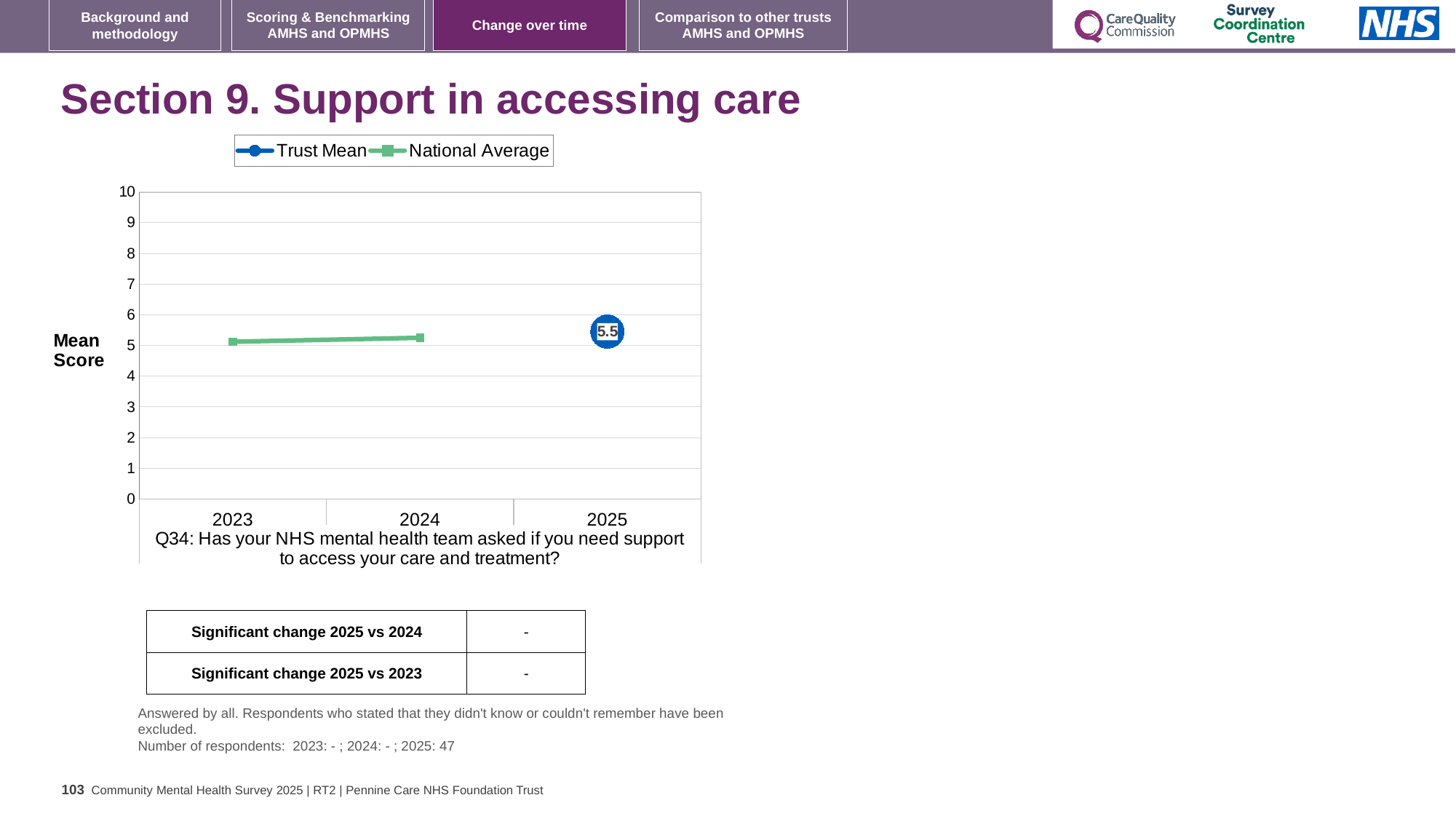
Is the Trust Mean value for 2025 greater or less than 5? greater What is the highest value shown on the y axis? 10 How many series does the legend list? 2 Is the National Average value for 2024 greater or less than 6? less What are the two series named in the legend? Trust Mean and National Average How many years are shown on the x axis? 3 Does the National Average rise or fall from 2023 to 2024? Rise Is the National Average value for 2023 greater or less than 7? less For which year is a Trust Mean data point plotted? 2025 What kind of chart is shown on the slide? Line chart What is the label on the y axis of the chart? Mean Score What is the Trust Mean value shown for 2025? 5.5